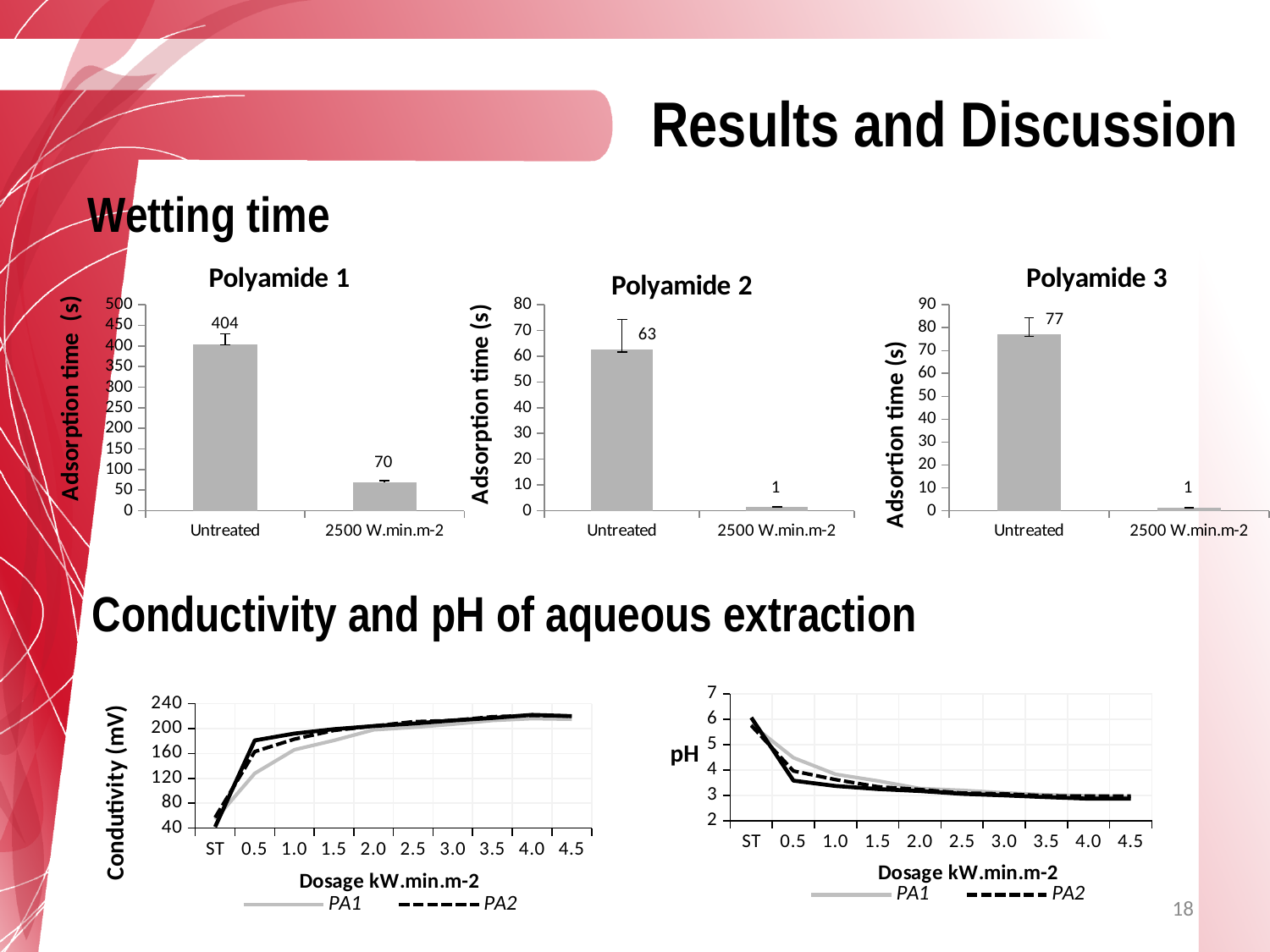
In the Polyamide 2 chart, which category has the lowest adsorption time? 2500 W.min.m-2 In the Polyamide 3 chart, what is the adsorption time for the 2500 W.min.m-2 sample? 1 How many series does the legend of the Conductivity chart at the bottom left list? 2 In the Polyamide 3 chart, which category has the highest adsorption time? Untreated In the Polyamide 1 chart, what is the adsorption time for the 2500 W.min.m-2 sample? 70 What kind of chart is the Polyamide 2 chart? Bar chart In the pH chart at the bottom right, do the values rise or fall as dosage increases along the x axis? Fall In the Polyamide 2 chart, what is the adsorption time for the Untreated sample? 63 In the Polyamide 1 chart, what is the adsorption time for the Untreated sample? 404 In the Polyamide 1 chart, what is the difference in adsorption time between the Untreated and 2500 W.min.m-2 samples? 334 In the pH chart at the bottom right, is the PA1 value at ST greater or less than 5? greater In the Conductivity chart at the bottom left, do the values rise or fall as dosage increases along the x axis? Rise